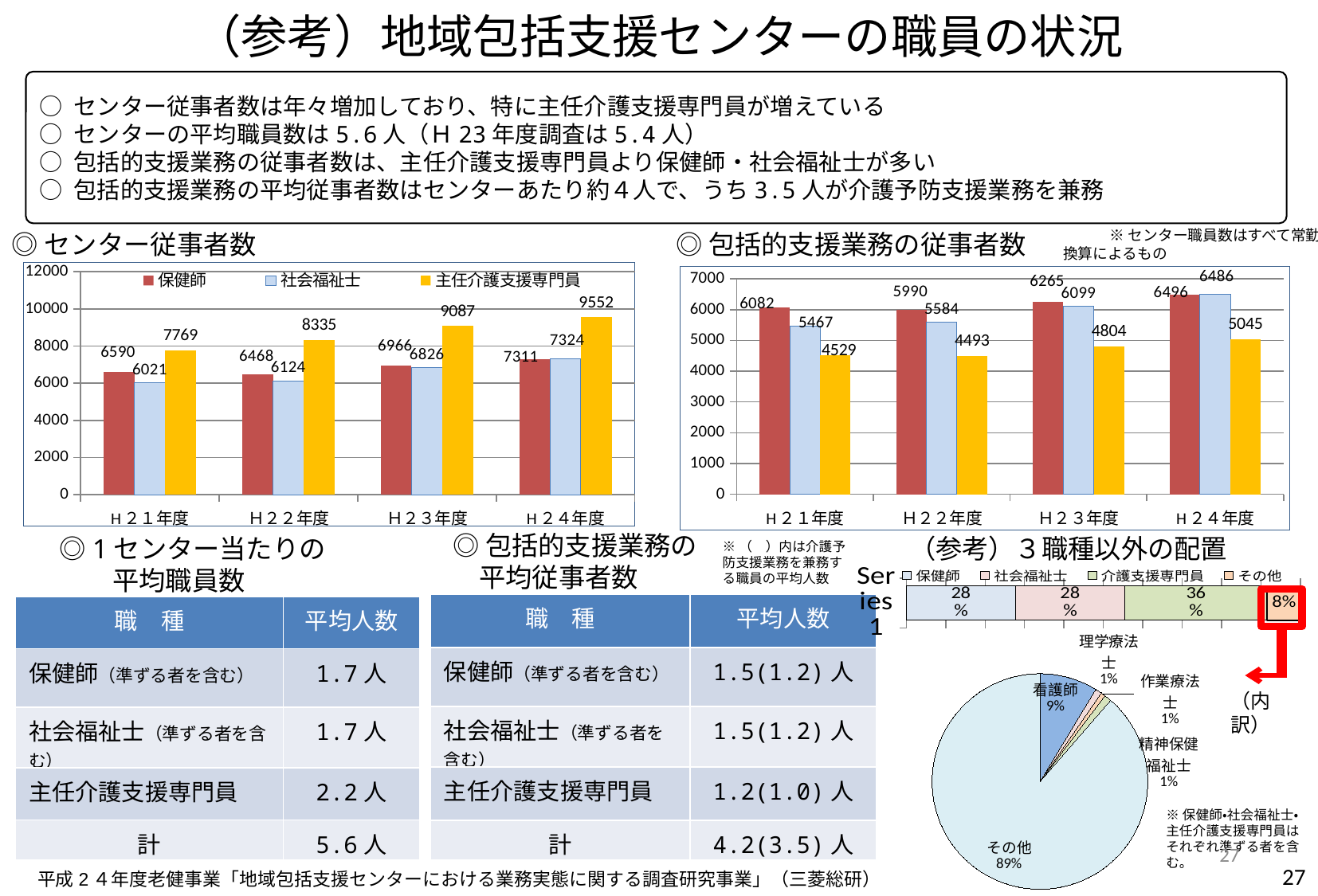
In the センター従事者数 chart, what is the value for 主任介護支援専門員 in Ｈ２４年度? 9552 In the センター従事者数 chart, what is the value for 社会福祉士 in Ｈ２１年度? 6021 In the （参考）３職種以外の配置 stacked bar, what is the share for 介護支援専門員? 36% How many series does the legend of the センター従事者数 chart list? 3 In the 包括的支援業務の従事者数 chart, how many year categories are shown on the x axis? 4 In the センター従事者数 chart, do the values for 主任介護支援専門員 rise or fall from Ｈ２１年度 to Ｈ２４年度? rise In the 包括的支援業務の従事者数 chart, what is the value of the red bar in Ｈ２４年度? 6496 In the センター従事者数 chart, what is the difference between 主任介護支援専門員 and 保健師 in Ｈ２２年度? 1867 What kind of chart is the 包括的支援業務の従事者数 chart? bar chart In the センター従事者数 chart, which series has the highest value in Ｈ２３年度? 主任介護支援専門員 In the 包括的支援業務の従事者数 chart, what is the value of the yellow bar in Ｈ２１年度? 4529 In the pie chart at the bottom right, what share does その他 have? 89%